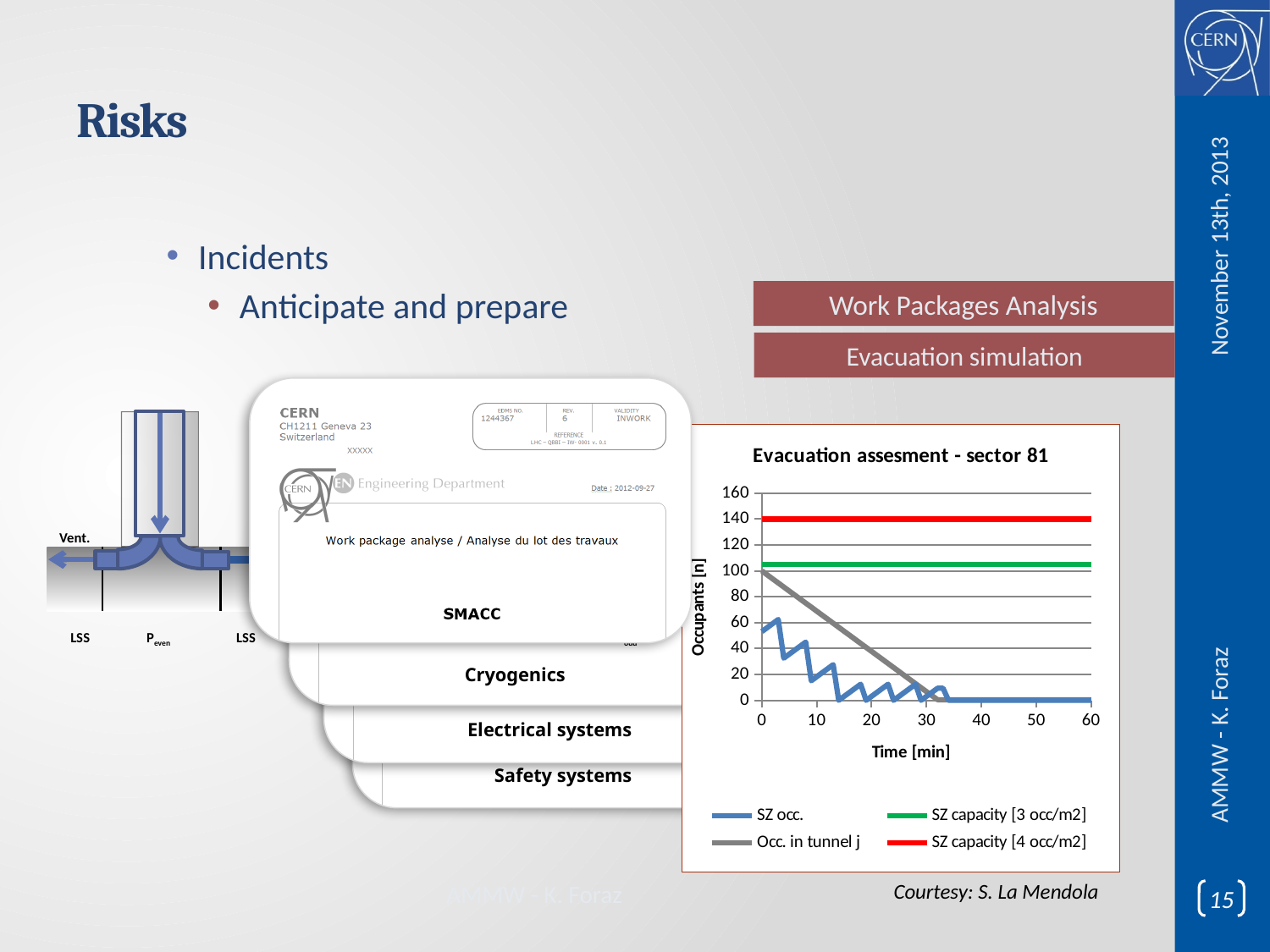
How many series does the chart legend list? 4 Does the Occ. in tunnel j series rise or fall as time increases? fall What is the label of the y axis of the chart? Occupants [n] What value does the SZ capacity [4 occ/m2] line sit at? 140 What kind of chart is shown on the slide? line chart Is the SZ capacity [3 occ/m2] line greater or less than 120? less Is the SZ capacity [4 occ/m2] line greater or less than 120? greater What is the highest value shown on the x axis (Time [min])? 60 What is the value of Occ. in tunnel j at time 0 min? 100 Does the SZ occ. series overall rise or fall as time increases? fall What is the title of the chart? Evacuation assesment - sector 81 Which is higher, the SZ capacity [3 occ/m2] line or the SZ capacity [4 occ/m2] line? SZ capacity [4 occ/m2]